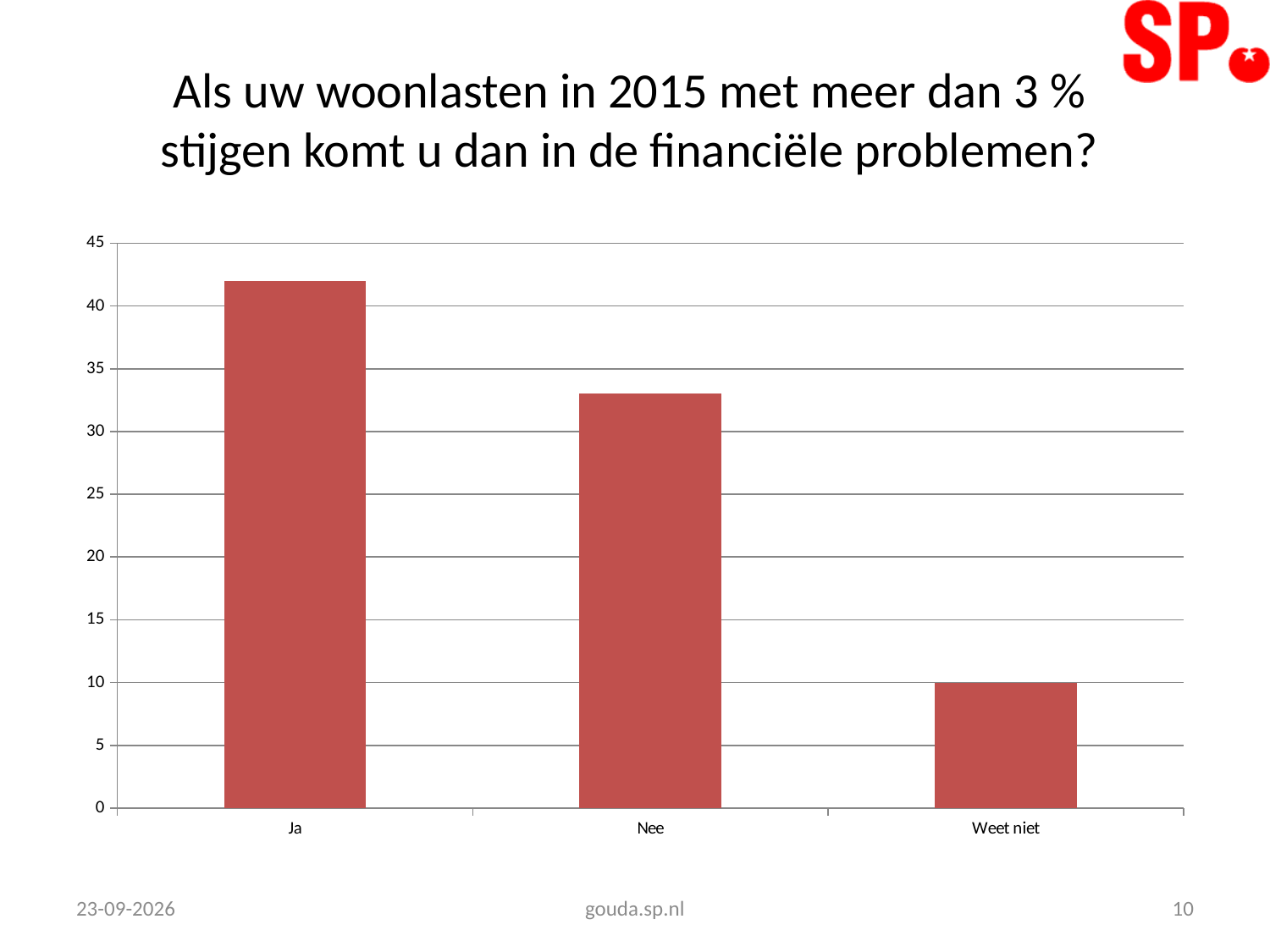
Is the value for Ja greater or less than 40? greater Is the value for Nee greater or less than 30? greater What is the highest value shown on the vertical axis of the chart? 45 Is the value for Ja greater or less than 45? less How many categories are shown on the x axis of the chart? 3 Which is larger, the value for Ja or the value for Nee? Ja Do the bar values rise or fall from left to right along the x axis? fall Which category has the lowest bar in the chart? Weet niet What kind of chart is shown on the slide? bar chart Which category has the highest bar in the chart? Ja What is the value for Weet niet in the chart? 10